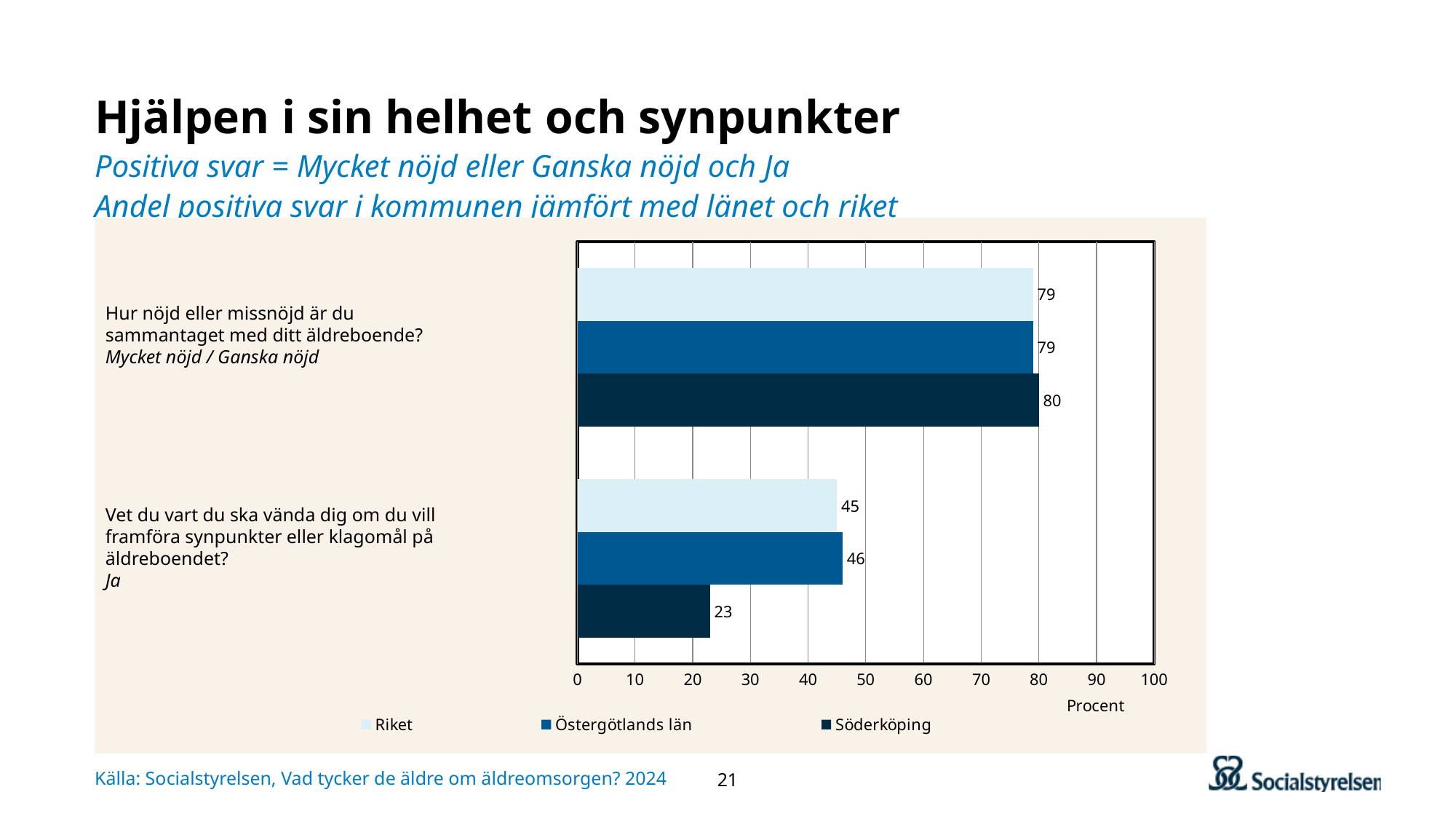
Is the value for Söderköping on the question "Vet du vart du ska vända dig om du vill framföra synpunkter eller klagomål på äldreboendet?" greater or less than 30? less What is the value for Östergötlands län on the question "Vet du vart du ska vända dig om du vill framföra synpunkter eller klagomål på äldreboendet?"? 46 What is the value for Riket on the question "Vet du vart du ska vända dig om du vill framföra synpunkter eller klagomål på äldreboendet?"? 45 What is the value for Riket on the question "Hur nöjd eller missnöjd är du sammantaget med ditt äldreboende?"? 79 Which is larger for Söderköping: the value for "Hur nöjd eller missnöjd är du sammantaget med ditt äldreboende?" or the value for "Vet du vart du ska vända dig om du vill framföra synpunkter eller klagomål på äldreboendet?"? Hur nöjd eller missnöjd är du sammantaget med ditt äldreboende? What is the value for Söderköping on the question "Hur nöjd eller missnöjd är du sammantaget med ditt äldreboende?"? 80 What is the difference between Östergötlands län and Söderköping on the question "Vet du vart du ska vända dig om du vill framföra synpunkter eller klagomål på äldreboendet?"? 23 How many series does the legend list? 3 What kind of chart is shown on the slide? bar chart What unit is shown on the x axis of the chart? Procent How many questions (categories) are shown in the chart? 2 Which series has the lowest value on the question "Vet du vart du ska vända dig om du vill framföra synpunkter eller klagomål på äldreboendet?"? Söderköping